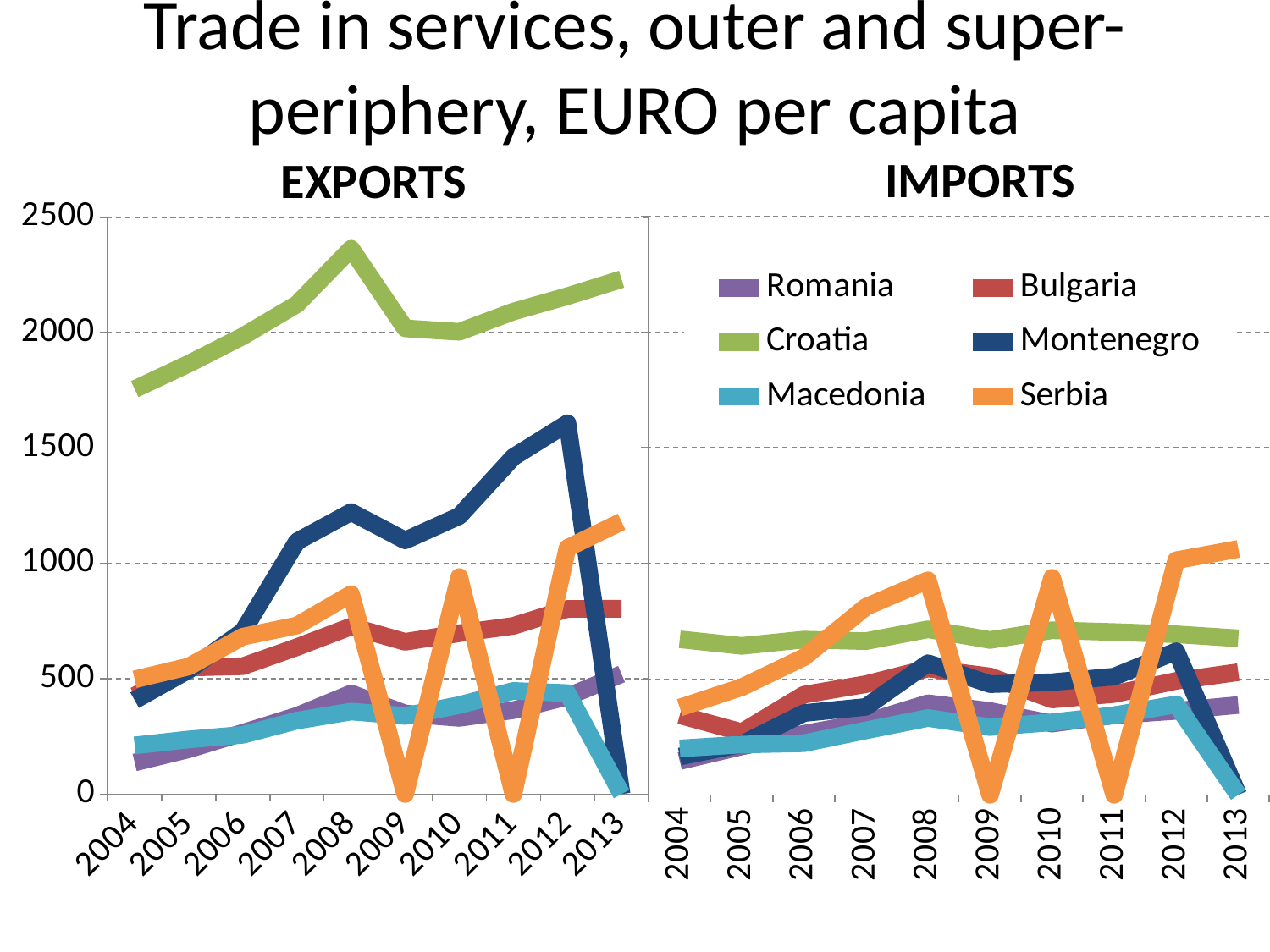
In the IMPORTS chart, is the value for Montenegro in 2013 greater or less than 500? less In the EXPORTS chart, which country has the lowest value in 2004? Romania In the IMPORTS chart, which is larger in 2008, Serbia or Croatia? Serbia In the EXPORTS chart, does the Croatia line rise or fall from 2004 to 2008? rise In the IMPORTS chart, is the value for Croatia in 2004 greater or less than 500? greater How many years are shown on the x axis of the IMPORTS chart? 10 In the EXPORTS chart, is the value for Montenegro in 2012 greater or less than 1500? greater In the EXPORTS chart, which country has the highest value in 2008? Croatia Which colour represents Croatia in the legend? green How many series does the legend list? 6 What kind of chart is the EXPORTS chart? line chart